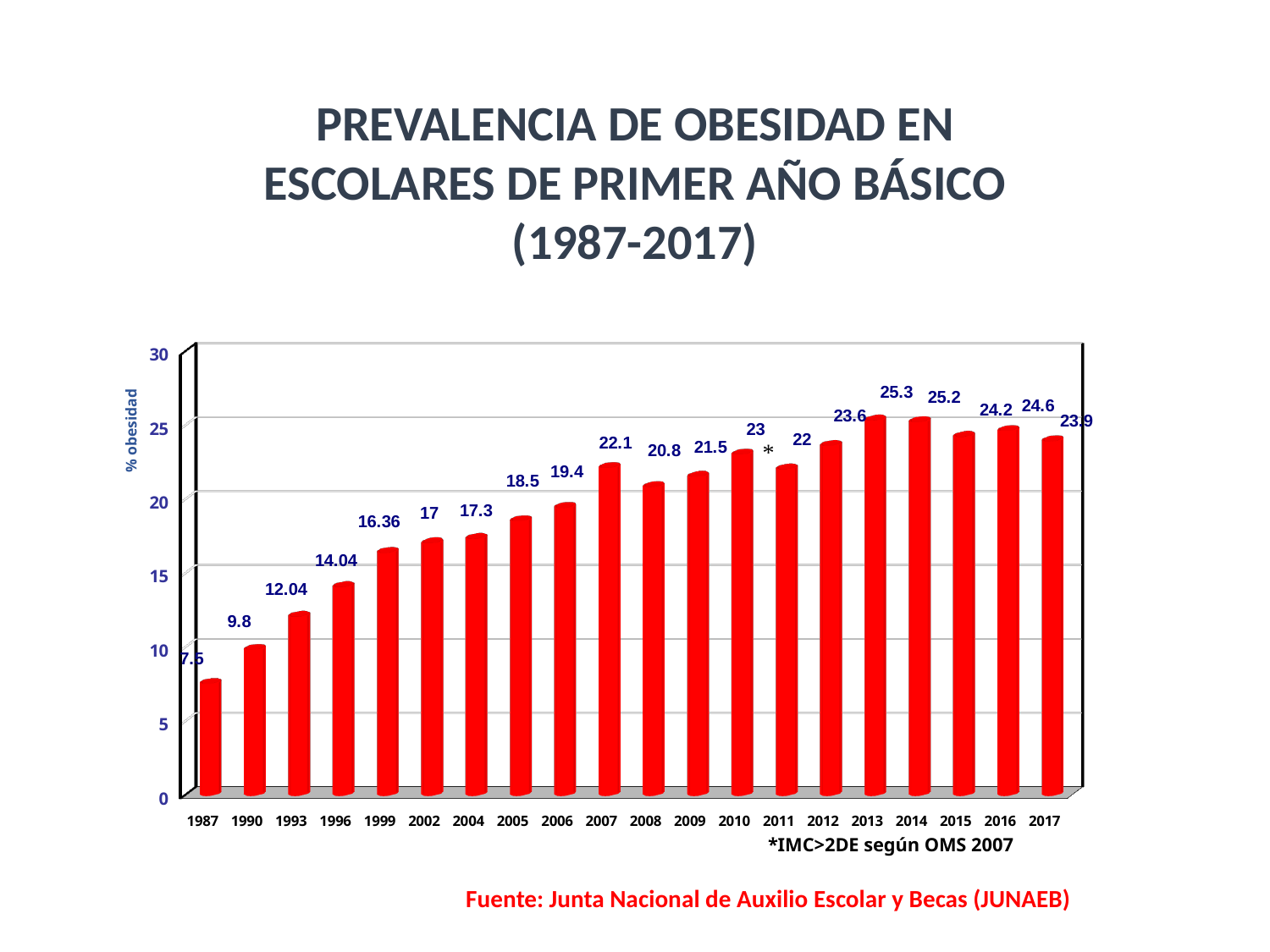
What is the obesity prevalence value for 2017? 23.9 Which year has a larger value, 2008 or 2010? 2010 Do the values generally rise or fall from 1987 to 2013? rise How many years are shown on the x axis? 20 What type of chart is shown on the slide? bar chart Which year has the lowest obesity prevalence? 1987 Which year has the highest obesity prevalence? 2013 What is the obesity prevalence value for 1999? 16.36 What is the obesity prevalence value for 1987? 7.5 What is the difference between the values for 2013 and 1987? 17.8 What is the label of the y axis? % obesidad What is the obesity prevalence value for 2007? 22.1